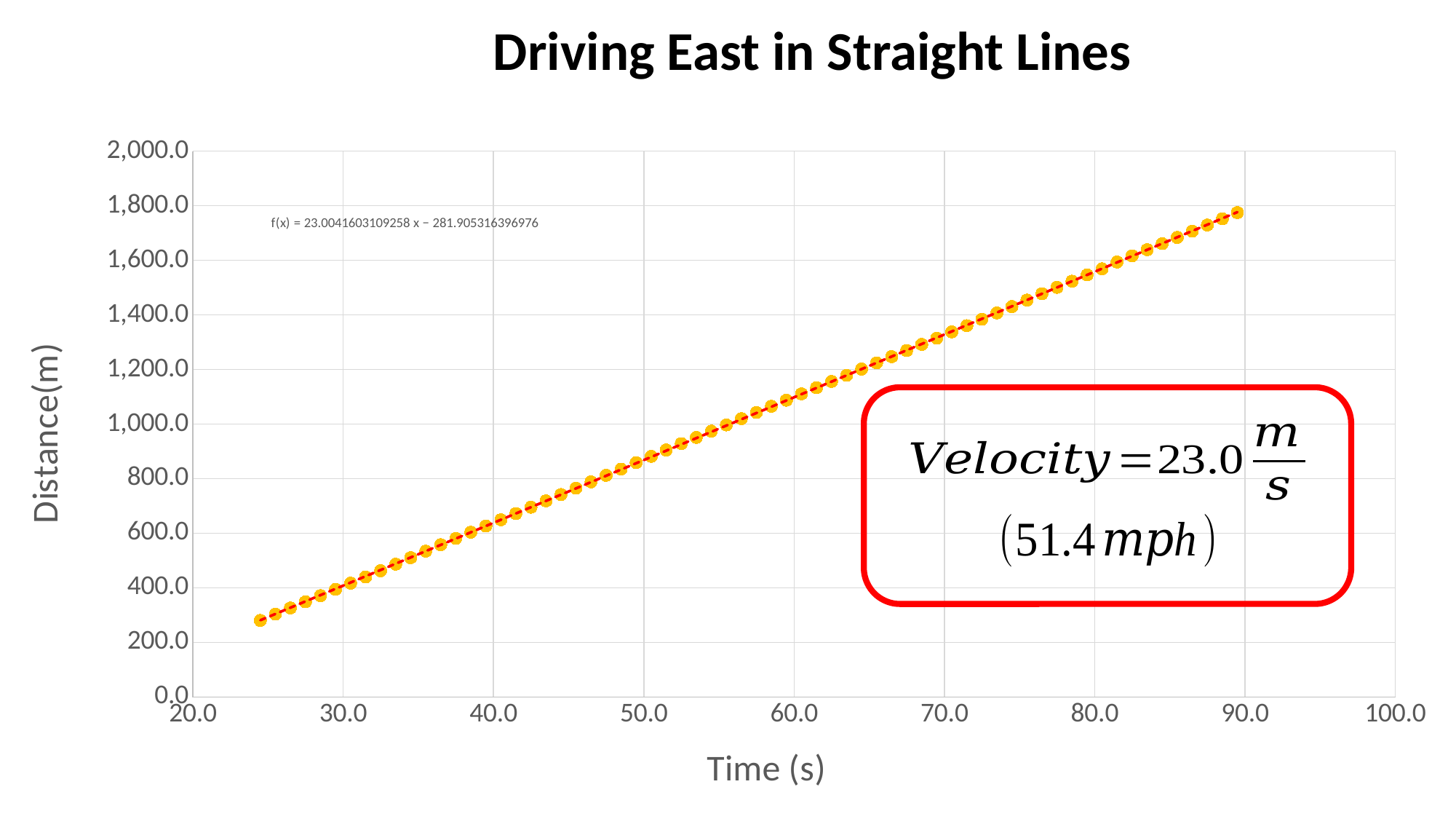
Do the distance values rise or fall as time increases along the x axis? Rise Is the distance at the last plotted point (around 90 s) greater or less than 1,600.0 m? greater Is the distance at a time of 70.0 s greater or less than 1,200.0 m? greater What is the label of the x axis? Time (s) Is the distance at the first plotted point (around 24 s) greater or less than 400.0 m? less Is the distance at a time of 60.0 s larger or smaller than the distance at a time of 40.0 s? Larger What is the title of the chart? Driving East in Straight Lines What kind of chart is shown on the slide? Scatter chart